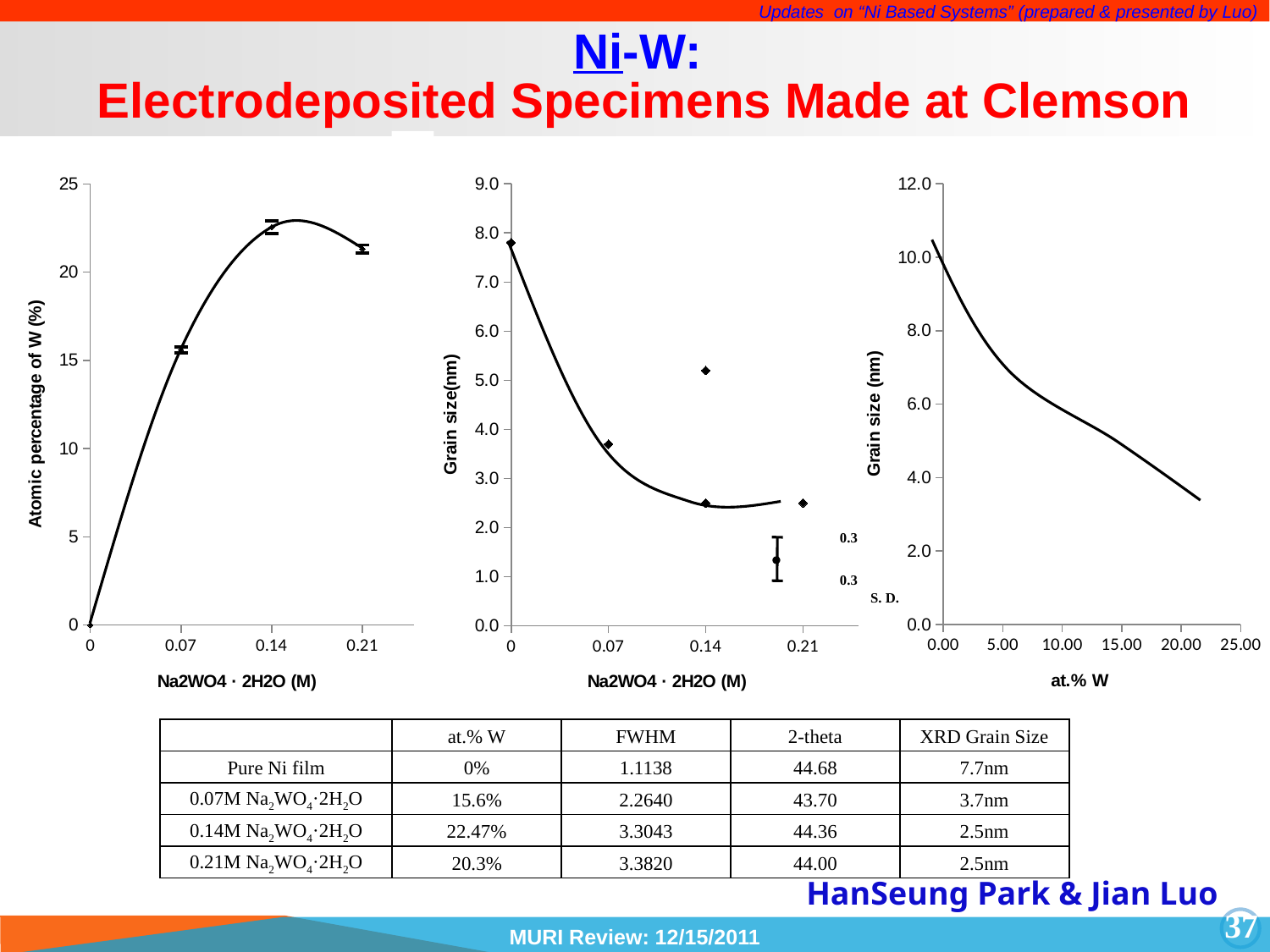
What kind of chart is the left chart (Atomic percentage of W vs Na2WO4 · 2H2O)? line chart On the right chart, what is the x-axis title? at.% W On the left chart, what is the y-axis title? Atomic percentage of W (%) On the left chart, is the value at 0.07 M Na2WO4 · 2H2O greater or less than 10? greater On the left chart, at which Na2WO4 · 2H2O concentration is the atomic percentage of W lowest? 0 On the middle chart (Grain size vs Na2WO4 · 2H2O), is the grain size on the curve at 0.14 M greater or less than 3.0 nm? less On the left chart, is the value at 0.14 M Na2WO4 · 2H2O greater or less than 20? greater On the left chart, at which Na2WO4 · 2H2O concentration is the atomic percentage of W highest? 0.14 On the middle chart (Grain size vs Na2WO4 · 2H2O), does the grain size rise or fall as the concentration increases from 0 to 0.14 M? fall On the right chart (Grain size vs at.% W), does the grain size rise or fall as at.% W increases? fall